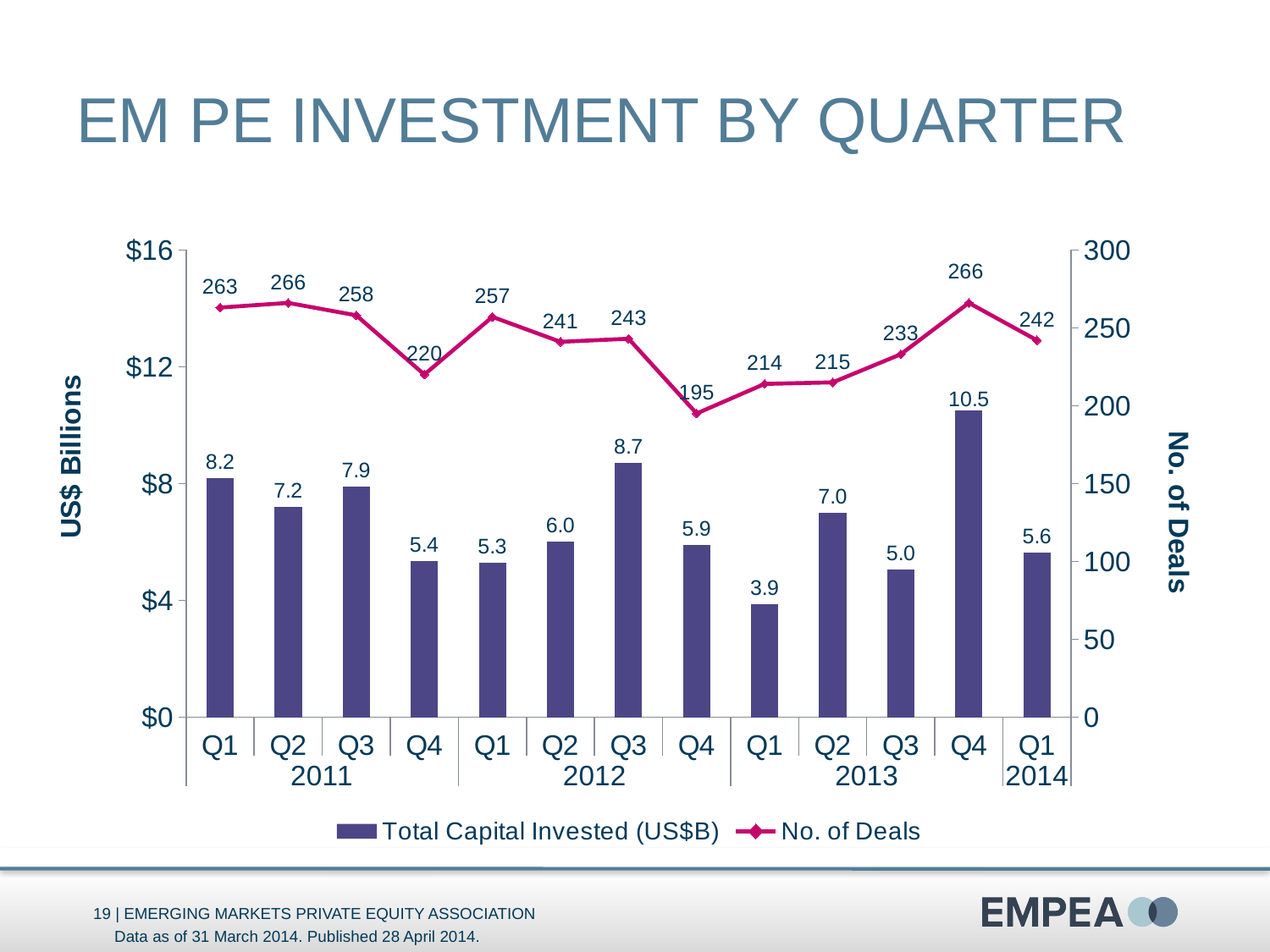
What is the difference in the number of deals between Q1 2011 and Q4 2011? 43 How many quarters are shown on the x axis? 13 What is the difference in Total Capital Invested (US$B) between Q4 2013 and Q1 2013? 6.6 Which quarter had more deals, Q3 2013 or Q1 2014? Q1 2014 What is the title of the chart? EM PE INVESTMENT BY QUARTER How many deals were recorded in Q4 2012? 195 How many series does the legend list? 2 Which quarter had the highest Total Capital Invested? Q4 2013 What was the Total Capital Invested (US$B) in Q4 2013? 10.5 Which quarter had the lowest number of deals? Q4 2012 What was the Total Capital Invested (US$B) in Q1 2014? 5.6 Which quarter had the lowest Total Capital Invested? Q1 2013